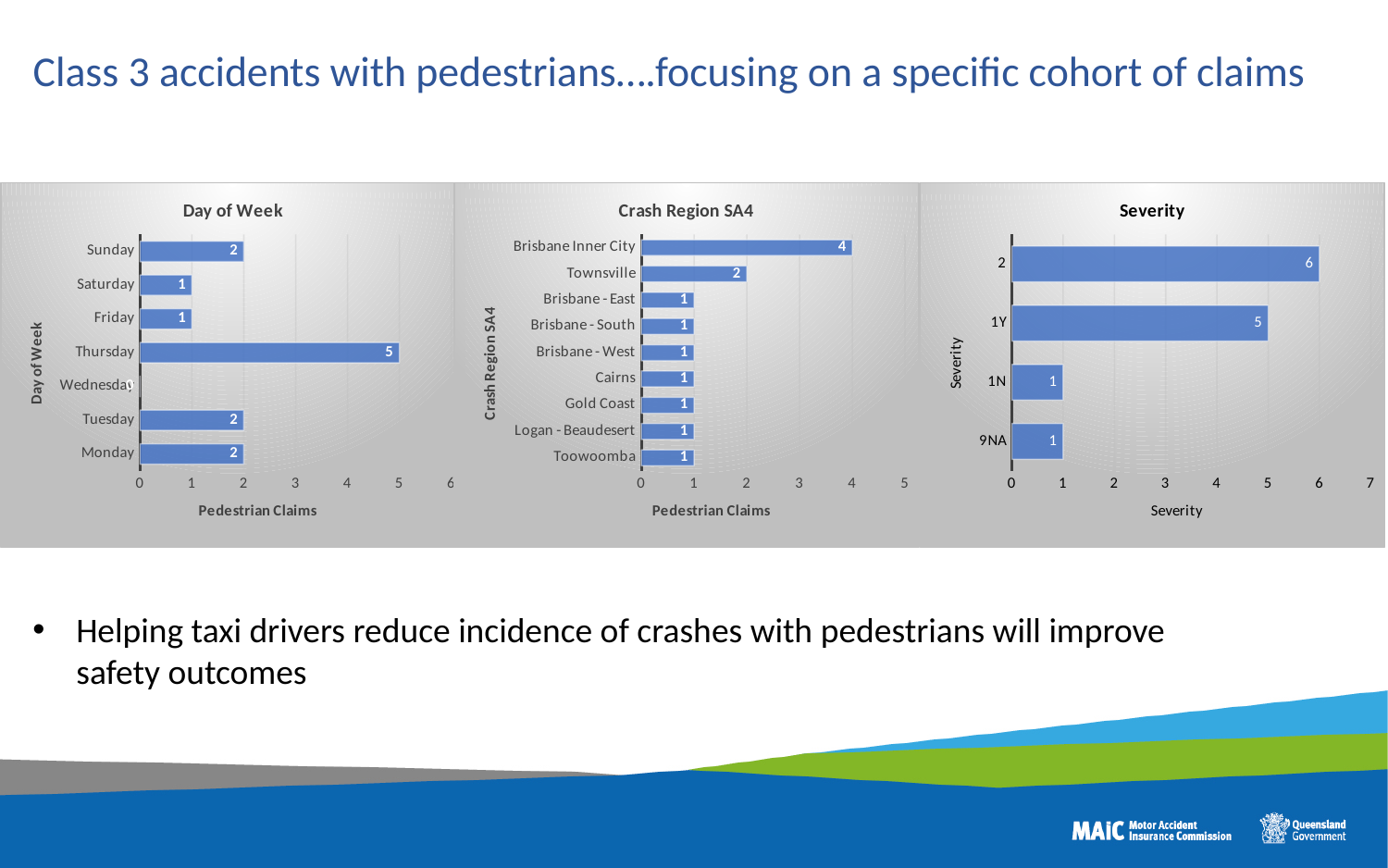
In the Severity chart, which severity category has the highest value? 2 In the Day of Week chart, which day has the highest number of pedestrian claims? Thursday In the Crash Region SA4 chart, how many regions are listed? 9 In the Severity chart, what is the difference between the values for category 2 and category 1N? 5 In the Day of Week chart, how many days of the week are listed on the axis? 7 In the Severity chart, what is the value for severity category 1Y? 5 In the Crash Region SA4 chart, how many pedestrian claims are shown for Brisbane Inner City? 4 In the Crash Region SA4 chart, which has more pedestrian claims, Townsville or Cairns? Townsville In the Day of Week chart, how many pedestrian claims are shown for Thursday? 5 In the Crash Region SA4 chart, which region has the highest number of pedestrian claims? Brisbane Inner City What type of chart is the Day of Week chart? Bar chart In the Day of Week chart, what is the difference in pedestrian claims between Thursday and Sunday? 3